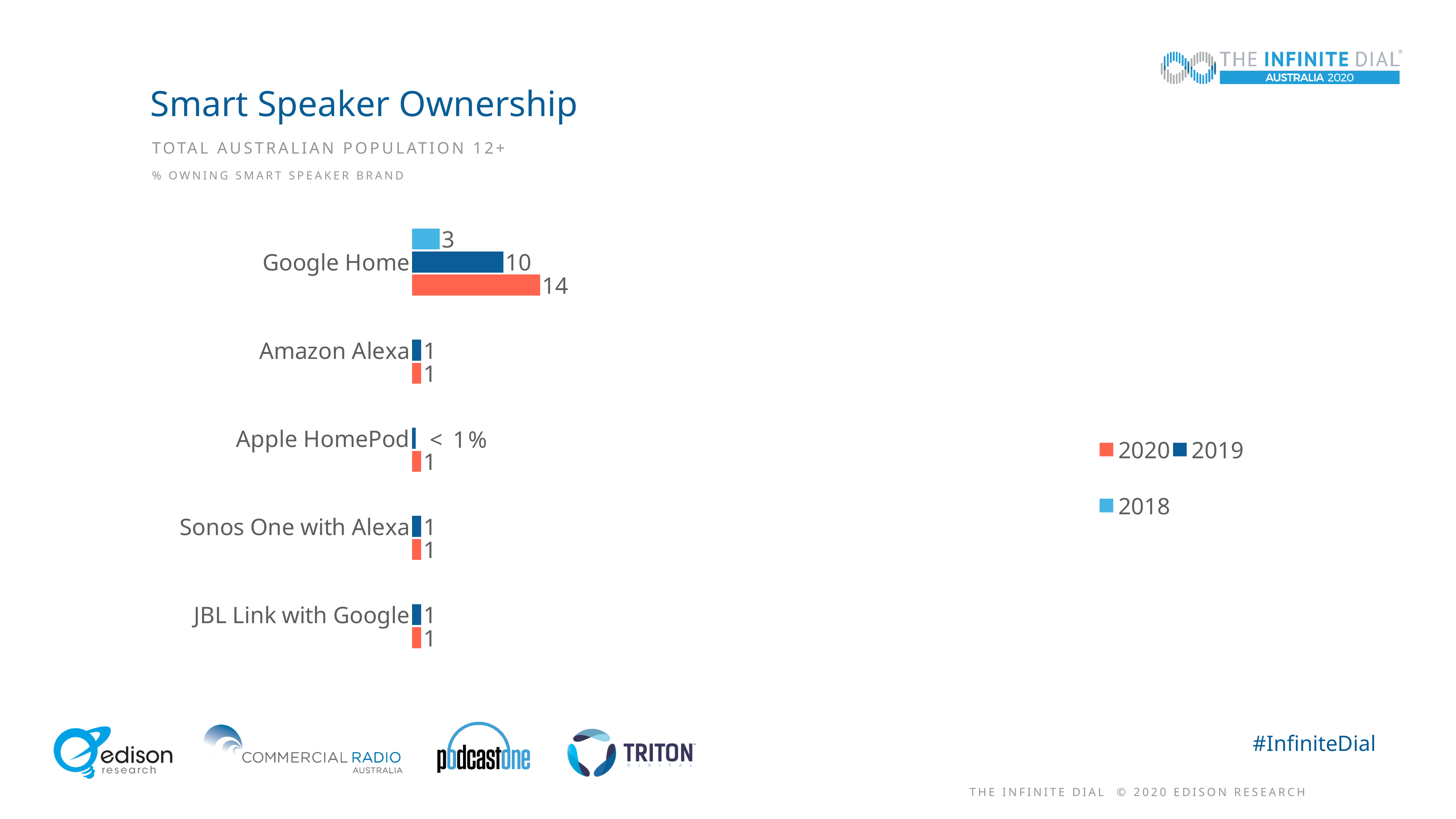
What is the 2019 value for Google Home? 10 What is the 2020 value for Amazon Alexa? 1 What is the 2020 value for Google Home? 14 What is the 2019 value for Apple HomePod? < 1% How many series does the legend list? 3 Which is larger for Google Home, the 2020 value or the 2018 value? 2020 How many smart speaker brands are shown on the chart? 5 Which brand has the highest 2020 value? Google Home What is the difference between the 2019 and 2018 values for Google Home? 7 What is the 2018 value for Google Home? 3 What is the difference between the 2020 and 2019 values for Google Home? 4 What kind of chart is shown on the slide? Bar chart